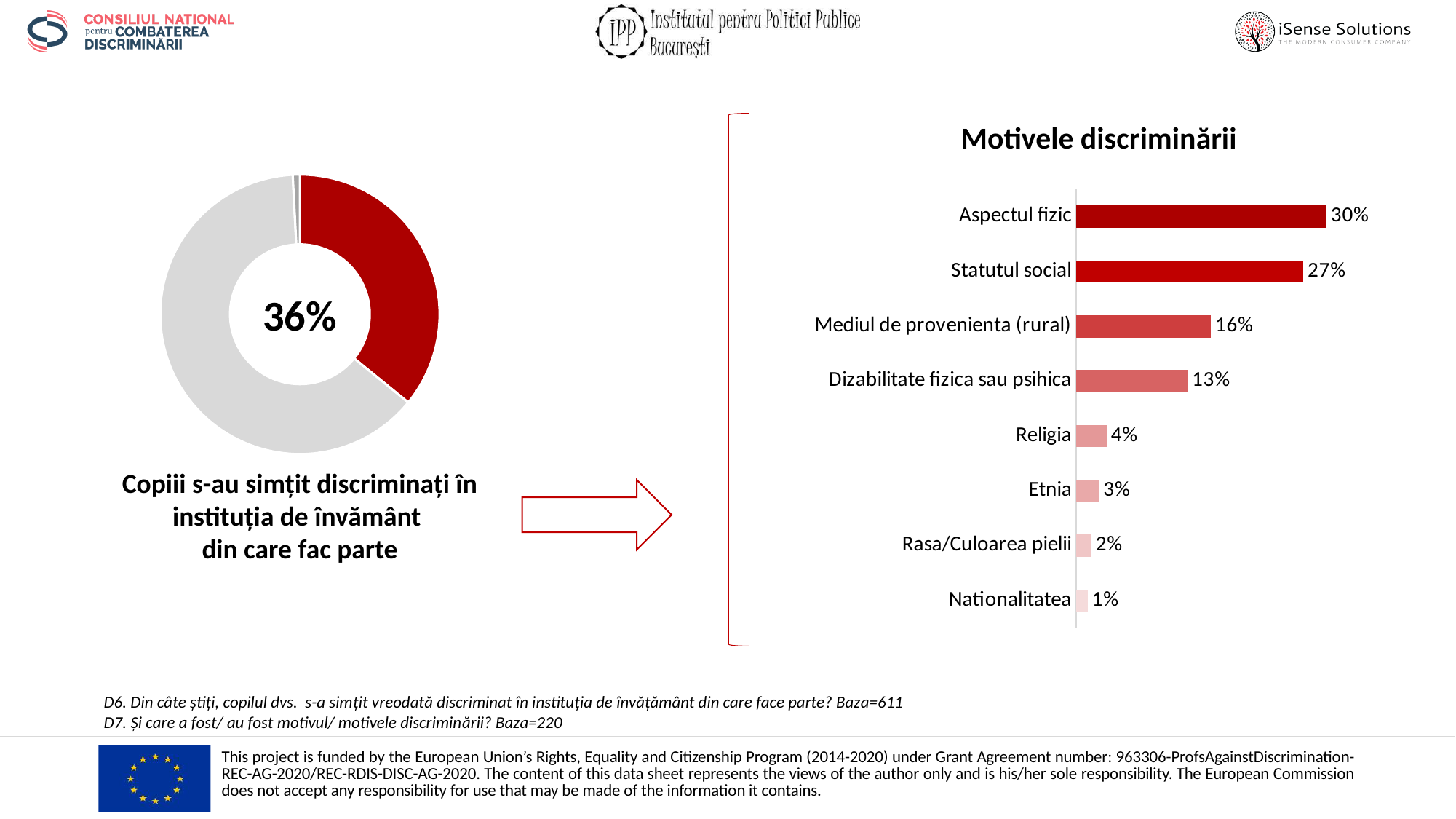
In the 'Motivele discriminării' bar chart, what is the difference between Statutul social and Dizabilitate fizica sau psihica? 14% In the 'Motivele discriminării' bar chart, which category has the highest value? Aspectul fizic In the 'Motivele discriminării' bar chart, what is the value for Aspectul fizic? 30% In the 'Motivele discriminării' bar chart, which category has the lowest value? Nationalitatea In the 'Motivele discriminării' bar chart, what is the value for Mediul de provenienta (rural)? 16% In the 'Motivele discriminării' bar chart, what is the value for Religia? 4% In the doughnut chart on the left, what percentage is shown in the centre? 36% What kind of chart is the 'Motivele discriminării' chart on the right? Bar chart How many categories are shown in the 'Motivele discriminării' bar chart? 8 What kind of chart is shown on the left side of the slide? Doughnut chart What is the title of the bar chart on the right? Motivele discriminării In the 'Motivele discriminării' bar chart, which is larger: Etnia or Rasa/Culoarea pielii? Etnia